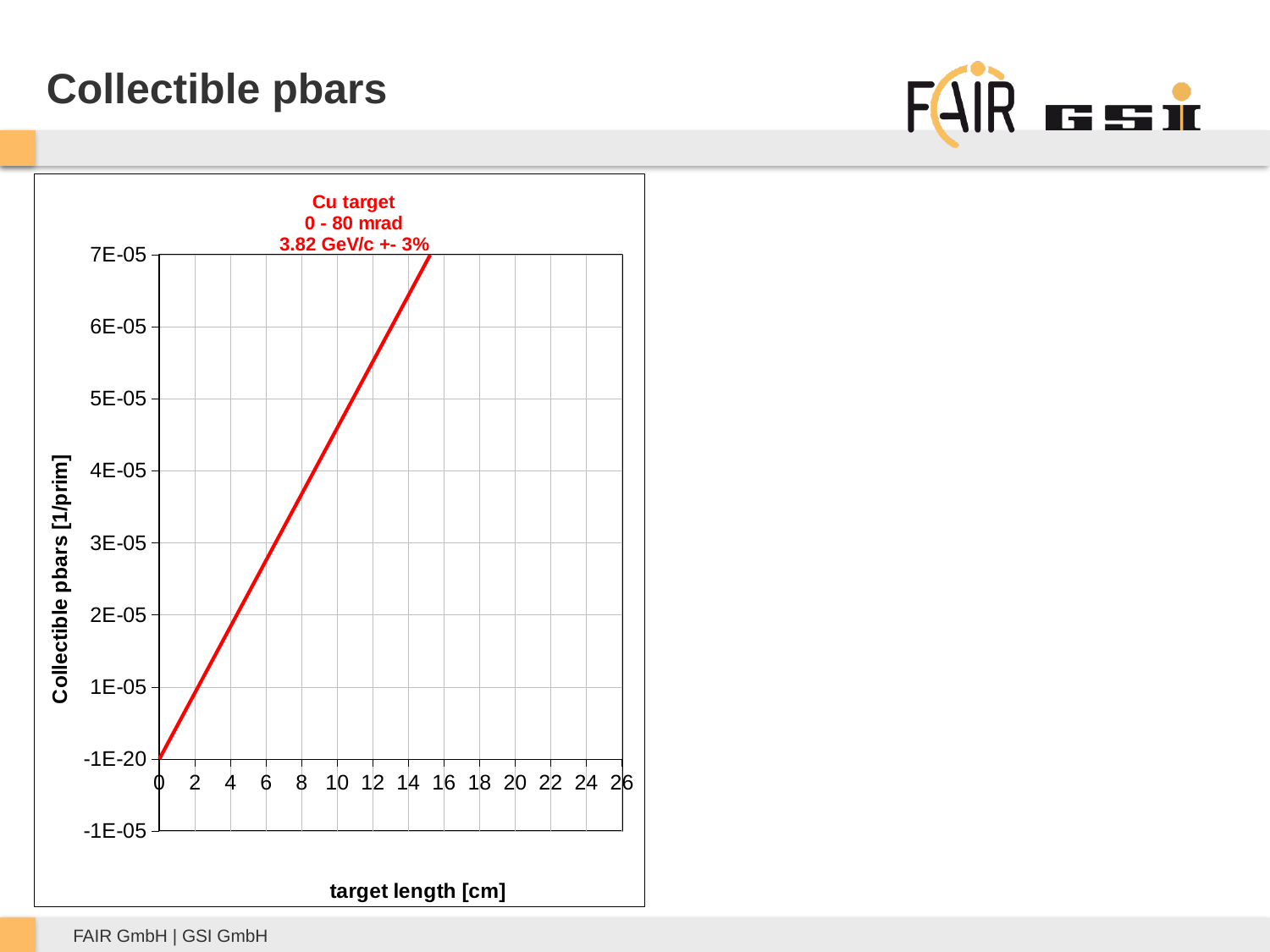
Is the value for a target length of 8 cm greater or less than 3E-05? greater Is the value for a target length of 6 cm greater or less than 3E-05? less Is the value for a target length of 10 cm greater or less than 4E-05? greater What target material is named in the chart title? Cu target What kind of chart is shown on the slide? line chart What is the label of the x axis? target length [cm] Which of the two target lengths, 6 cm or 12 cm, has the larger collectible pbars value? 12 cm Does the collectible pbars value rise or fall as target length increases? rise